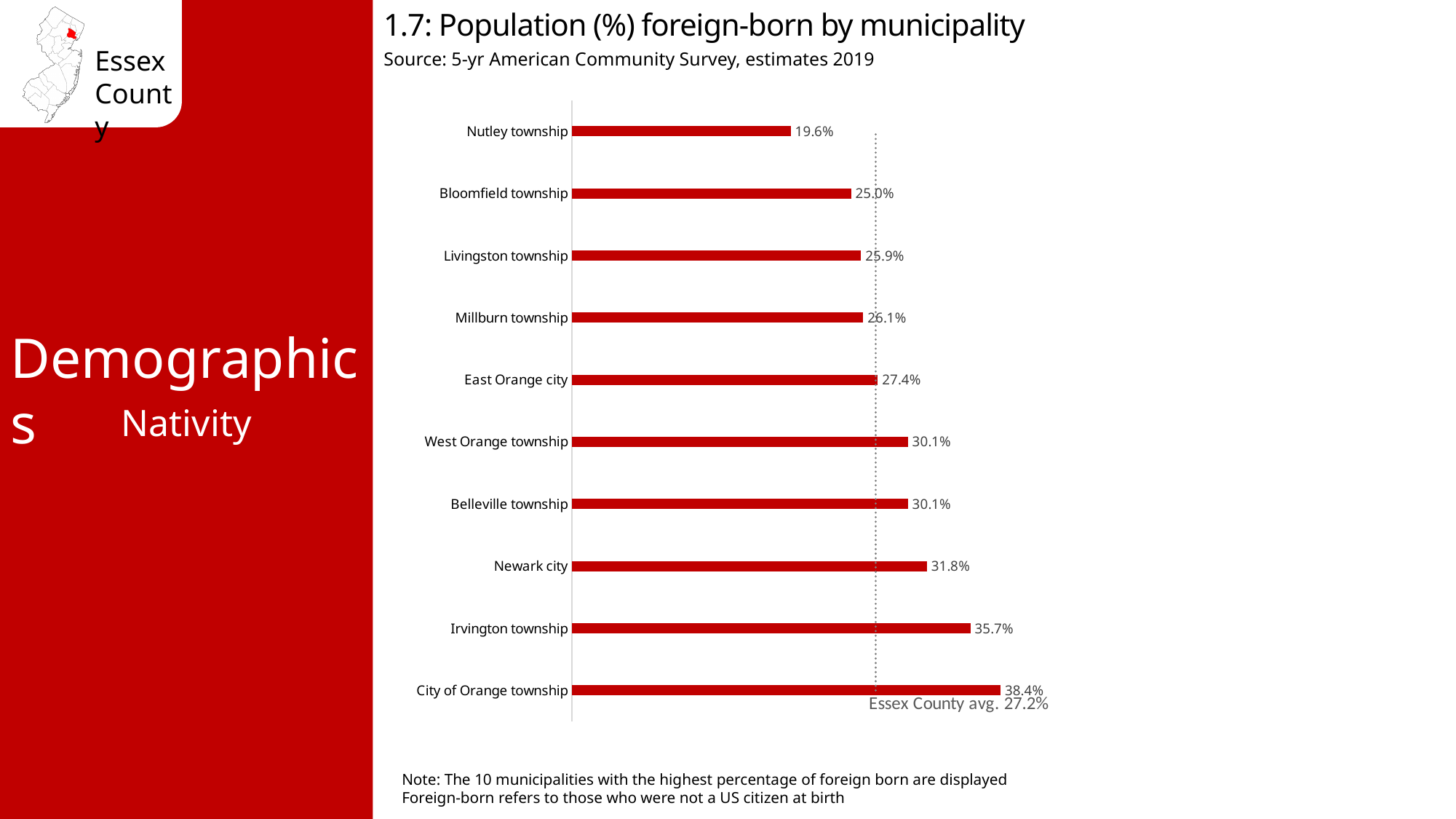
What is the source of the data in the chart? 5-yr American Community Survey, estimates 2019 Which has a higher foreign-born percentage, East Orange city or Bloomfield township? East Orange city Which municipality has the highest percentage of foreign-born population? City of Orange township What is the foreign-born population percentage for Irvington township? 35.7% What is the foreign-born population percentage for Nutley township? 19.6% What is the difference in foreign-born percentage between City of Orange township and Nutley township? 18.8% What kind of chart is used to show the foreign-born population by municipality? Bar chart What is the foreign-born population percentage for Newark city? 31.8% How many municipalities are shown in the chart? 10 What is the Essex County average foreign-born percentage shown by the dotted line? 27.2% What is the difference in foreign-born percentage between Irvington township and Newark city? 3.9% Which municipality has the lowest percentage of foreign-born population? Nutley township